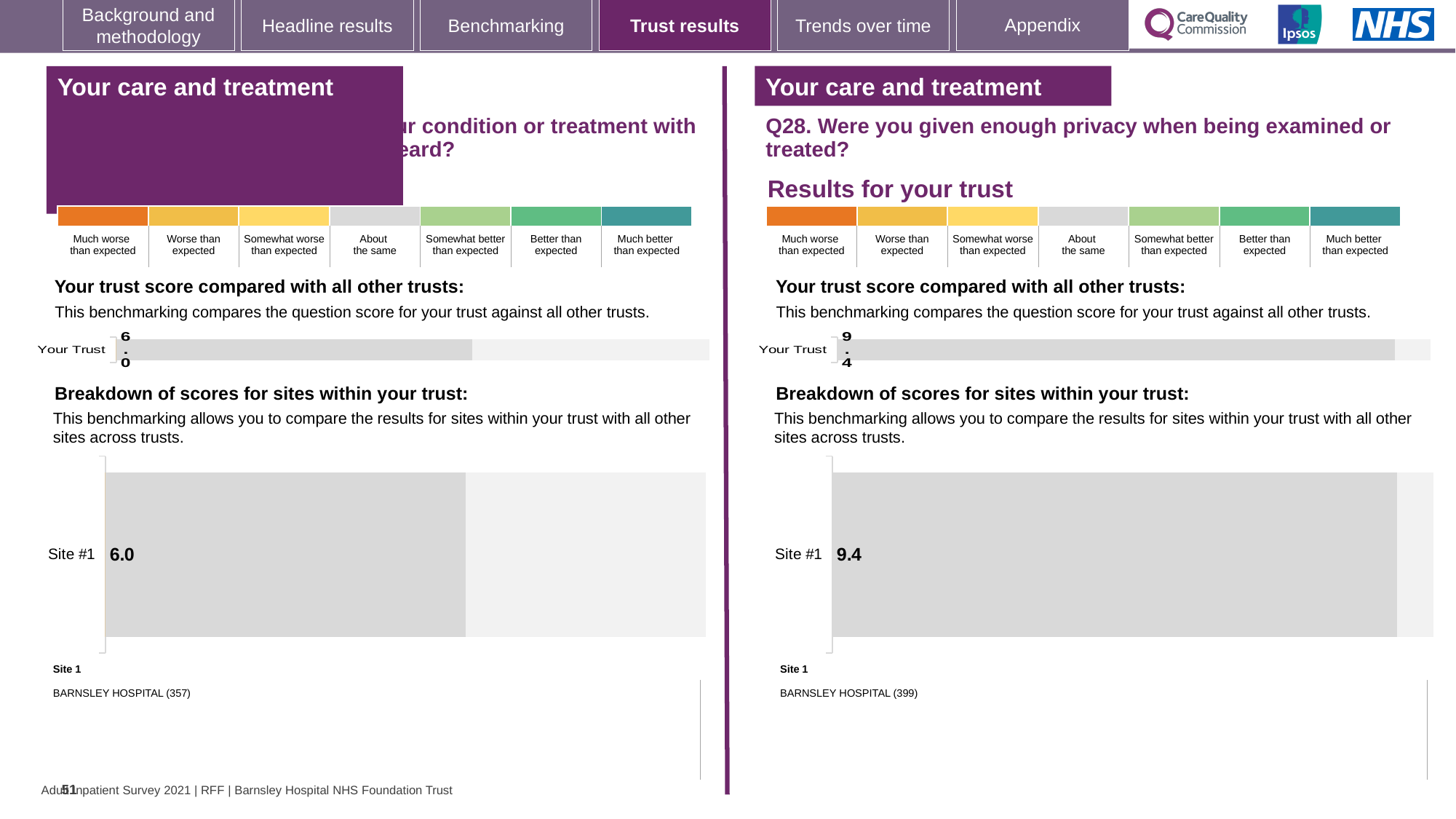
What type of chart is used to show the Your Trust score on the left-hand side of the slide? Bar chart Which site is listed as Site 1 beneath the right-hand (Q28) breakdown chart? BARNSLEY HOSPITAL (399) On the right-hand side of the slide (Q28), what is the score shown for Your Trust in the 'Your trust score compared with all other trusts' chart? 9.4 How many sites are shown in the 'Breakdown of scores for sites within your trust' chart on the left-hand side? 1 In the 'Breakdown of scores for sites within your trust' chart on the right-hand side (Q28), what is the value for Site #1? 9.4 On the left-hand side of the slide, what is the score shown for Your Trust in the 'Your trust score compared with all other trusts' chart? 6.0 Which is larger: the Site #1 score in the left-hand breakdown chart or the Site #1 score in the right-hand (Q28) breakdown chart? The right-hand (Q28) chart Which site is listed as Site 1 beneath the left-hand breakdown chart? BARNSLEY HOSPITAL (357) In the 'Breakdown of scores for sites within your trust' chart on the left-hand side, what is the value for Site #1? 6.0 What type of chart is used to show the Site #1 score in the right-hand (Q28) breakdown section? Bar chart What is the difference between the Your Trust score on the right-hand side (Q28) and the Your Trust score on the left-hand side? 3.4 How many sites are shown in the 'Breakdown of scores for sites within your trust' chart on the right-hand side (Q28)? 1